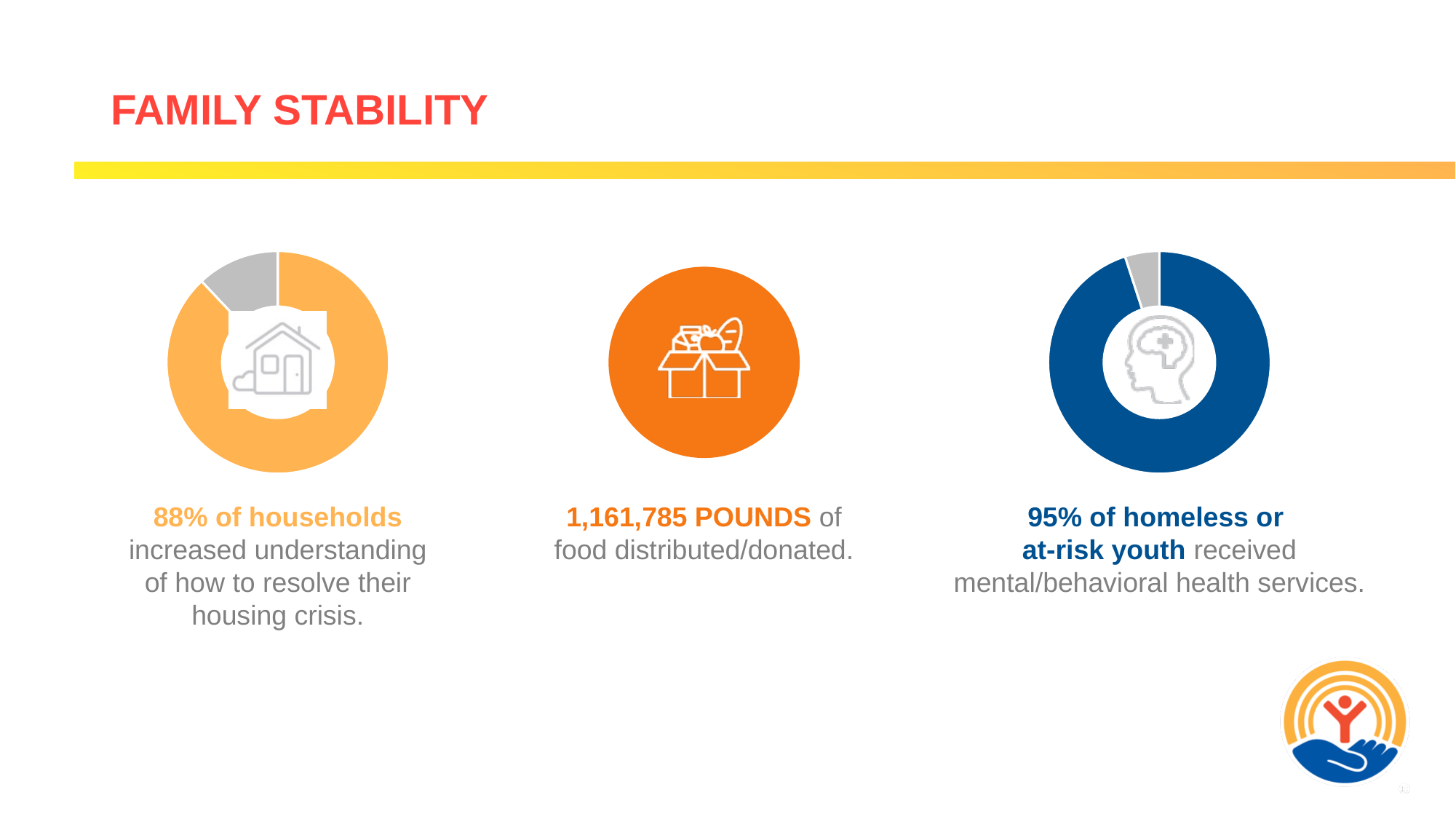
In the left donut chart, what percentage of households increased understanding of how to resolve their housing crisis? 88% What kind of chart is shown on the left of the slide, above the '88% of households' text? Donut (pie) chart In the right donut chart, is the gray (remaining) share greater or less than 50%? less What colour is the filled portion of the left donut chart? Orange In the left donut chart, is the filled (orange) share greater or less than 50%? greater What is the difference in percentage points between the right donut chart's value (95%) and the left donut chart's value (88%)? 7 percentage points How many slices does the left donut chart have? 2 What colour is the filled portion of the right donut chart? Dark blue How many donut charts are on the slide? 2 In the right donut chart, what percentage of homeless or at-risk youth received mental/behavioral health services? 95% What is the title of the slide containing the donut charts? FAMILY STABILITY Which donut chart shows the larger filled share: the left chart (households) or the right chart (homeless or at-risk youth)? The right chart (homeless or at-risk youth), 95%